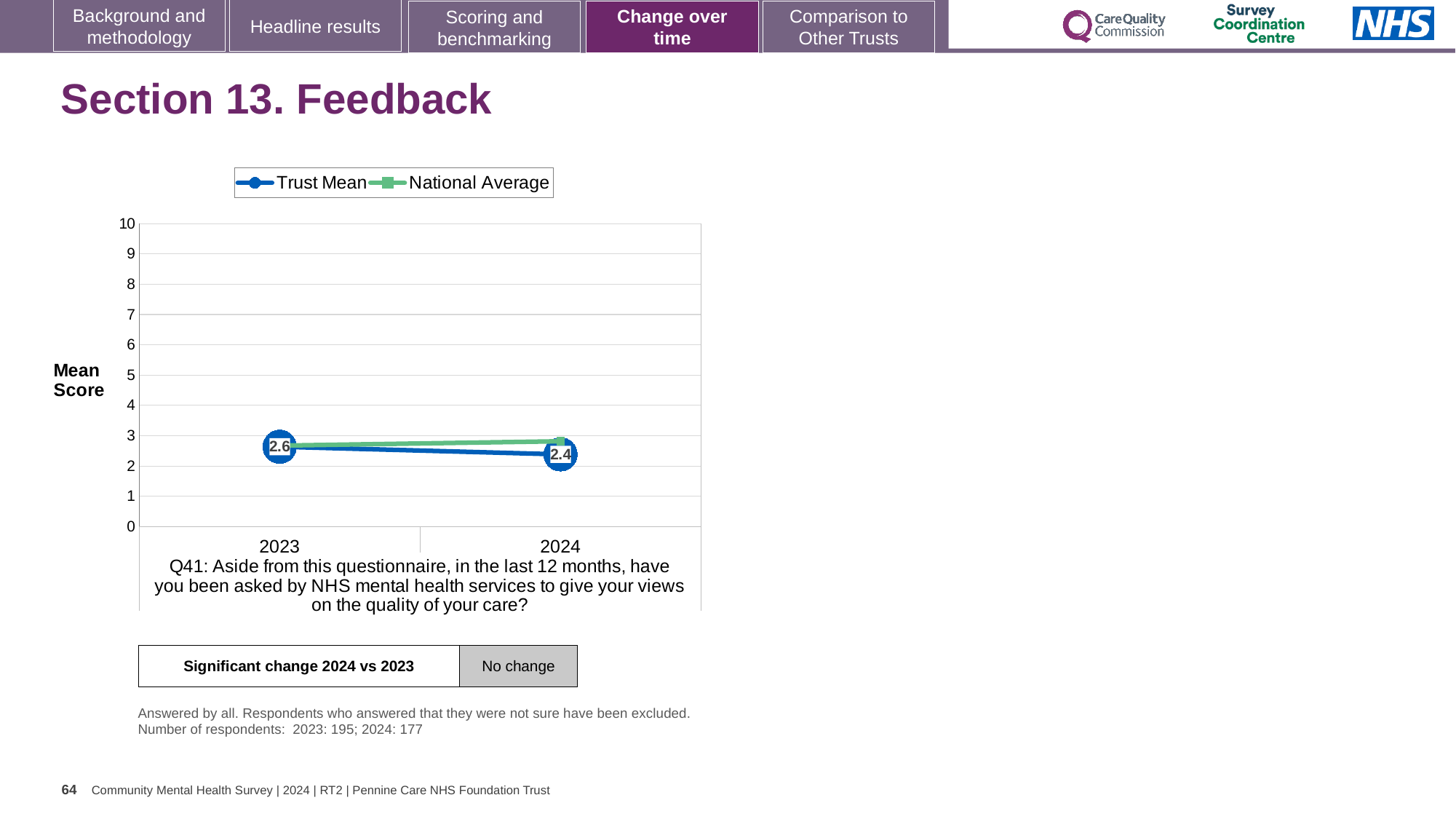
What kind of chart is shown on the slide? line chart What are the two series named in the legend? Trust Mean and National Average Which year has the higher Trust Mean score, 2023 or 2024? 2023 Is the National Average value for 2024 greater or less than 3? less In which year is the Trust Mean score highest? 2023 How many series does the legend list? 2 Does the Trust Mean line rise or fall from 2023 to 2024? fall What is the Trust Mean score for 2023? 2.6 In 2024, which is higher, the Trust Mean or the National Average? National Average How many years are plotted on the x axis? 2 What is the Trust Mean score for 2024? 2.4 By how much did the Trust Mean score change from 2023 to 2024? 0.2